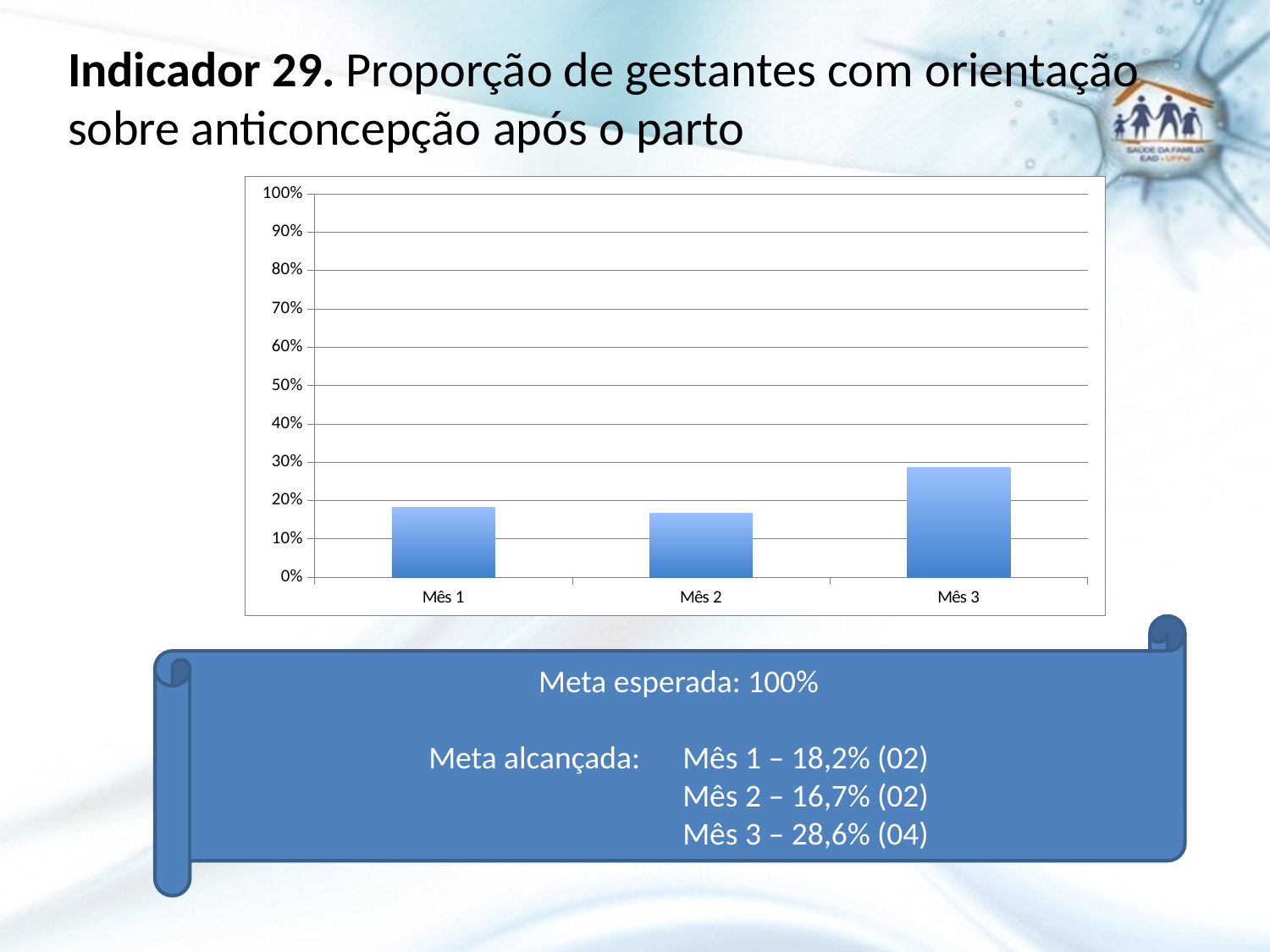
What is the value for Mês 2? 16,7% Which is larger, the value for Mês 3 or the value for Mês 1? Mês 3 Which month has the lowest value on the chart? Mês 2 Is the value for Mês 3 greater or less than 20%? greater How many categories (months) are plotted on the chart? 3 What is the expected target (meta esperada) stated on the slide? 100% Is the value for Mês 1 greater or less than 20%? less What is the value for Mês 1? 18,2% Which month has the highest value on the chart? Mês 3 What is the value for Mês 3? 28,6% What is the difference between the values for Mês 3 and Mês 2? 11,9% What kind of chart is shown on the slide? bar chart